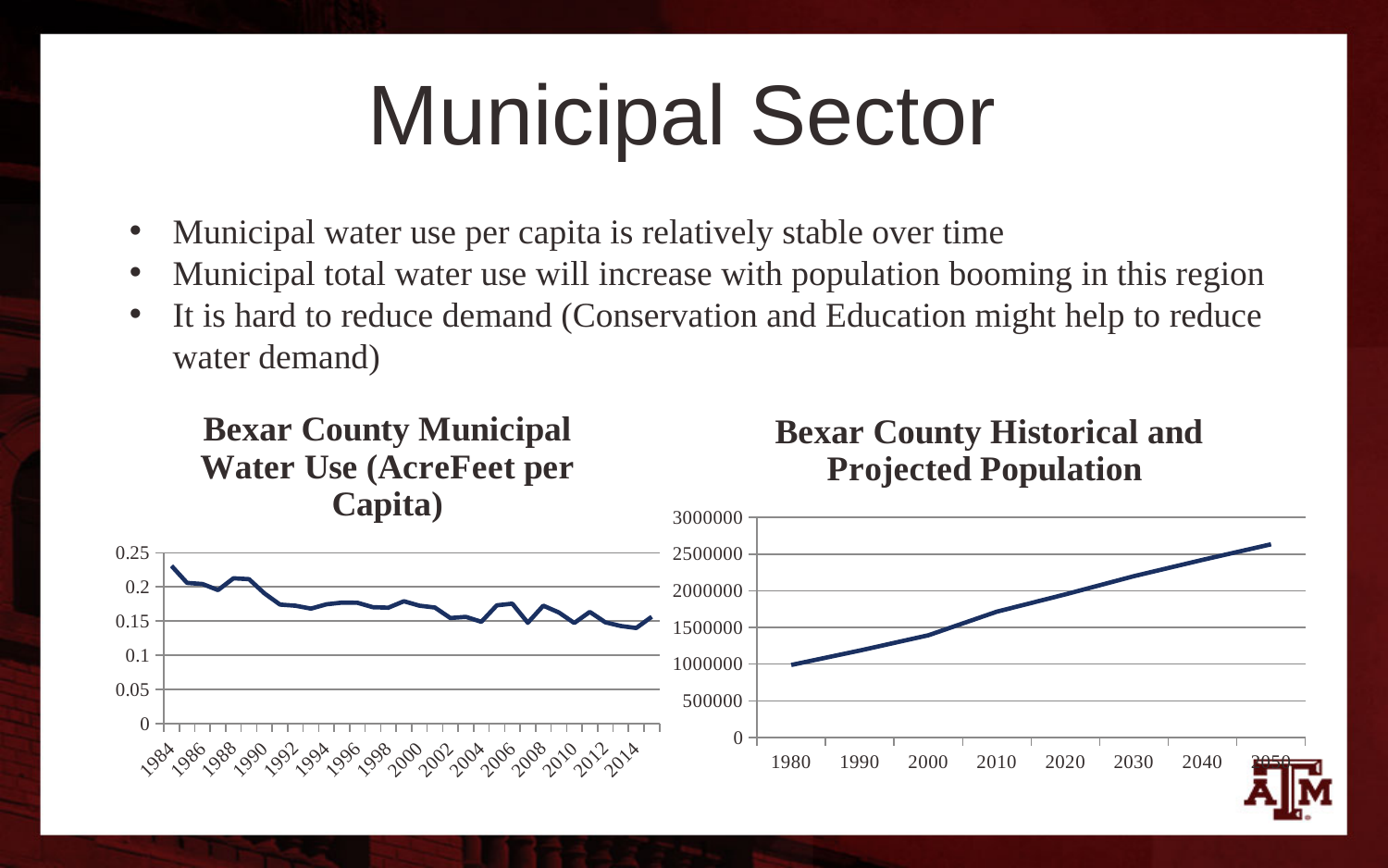
What kind of chart is the 'Bexar County Historical and Projected Population' chart? line chart In the 'Bexar County Municipal Water Use (AcreFeet per Capita)' chart, is the value for 1984 greater or less than 0.2? greater In the 'Bexar County Municipal Water Use (AcreFeet per Capita)' chart, which year has the highest value? 1984 In the 'Bexar County Historical and Projected Population' chart, is the value for 1980 greater or less than 1500000? less In the 'Bexar County Municipal Water Use (AcreFeet per Capita)' chart, which is larger, the value for 1984 or the value for 2014? 1984 In the 'Bexar County Historical and Projected Population' chart, which year has the lowest population? 1980 In the 'Bexar County Historical and Projected Population' chart, is the value for 2040 greater or less than 2000000? greater In the 'Bexar County Historical and Projected Population' chart, do the values rise or fall from 1980 to 2050? rise What kind of chart is the 'Bexar County Municipal Water Use (AcreFeet per Capita)' chart? line chart In the 'Bexar County Municipal Water Use (AcreFeet per Capita)' chart, do the values generally rise or fall from 1984 to 2014? fall What is the title of the chart on the right side of the slide? Bexar County Historical and Projected Population